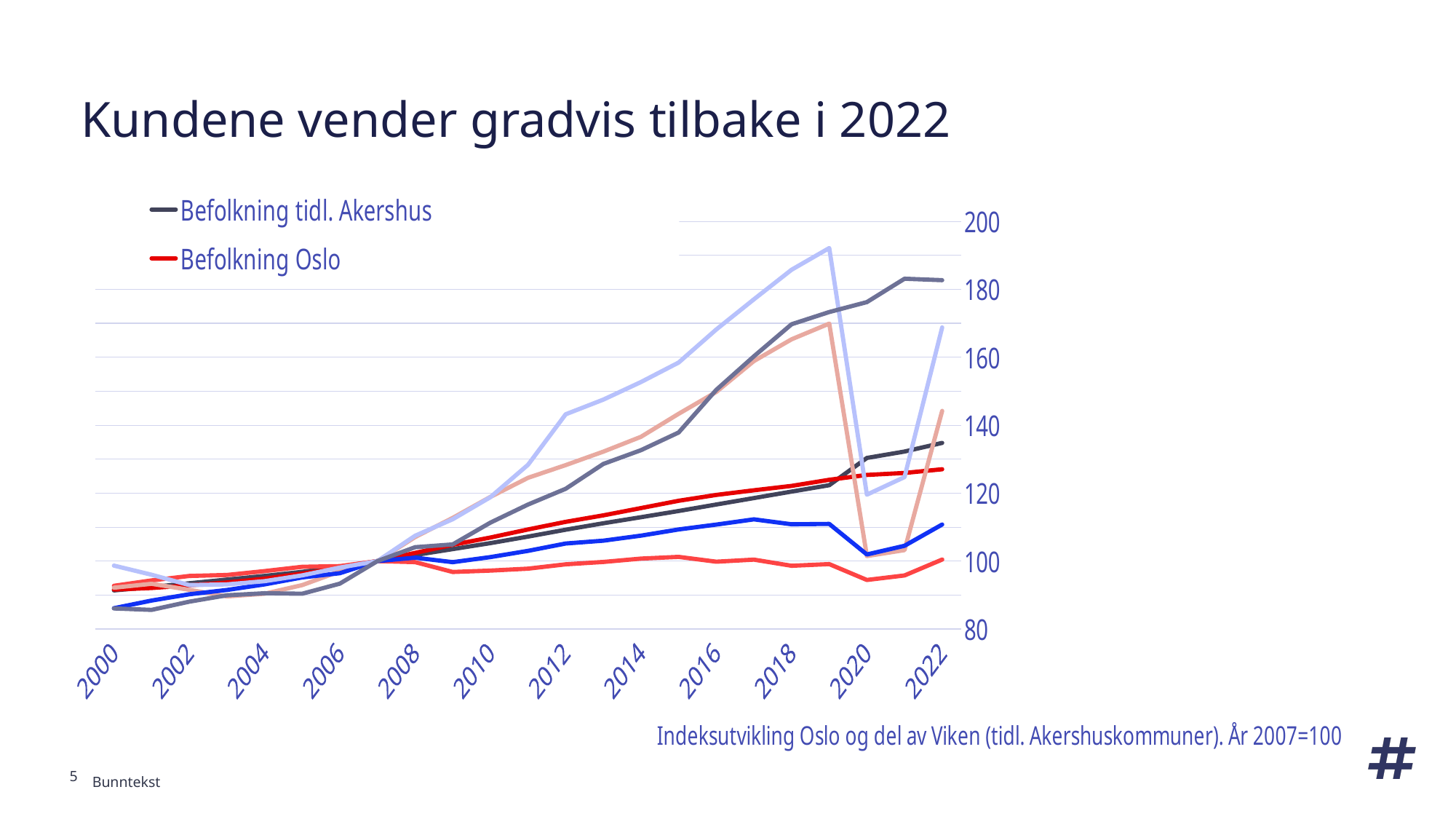
How many series does the chart's legend list? 2 In 2022, which is higher: Befolkning tidl. Akershus or Befolkning Oslo? Befolkning tidl. Akershus Is the value for Befolkning tidl. Akershus in 2000 greater or less than 100? less Does the Befolkning Oslo line rise or fall from 2000 to 2022? rise Does the Befolkning tidl. Akershus line rise or fall from 2000 to 2022? rise Is the value for Befolkning tidl. Akershus in 2016 greater or less than 120? less Is the value for Befolkning Oslo in 2022 greater or less than 120? greater What is the title of the slide containing the chart? Kundene vender gradvis tilbake i 2022 What are the two series named in the legend? Befolkning tidl. Akershus and Befolkning Oslo How many year labels are shown on the x axis? 12 What kind of chart is shown on the slide? line chart